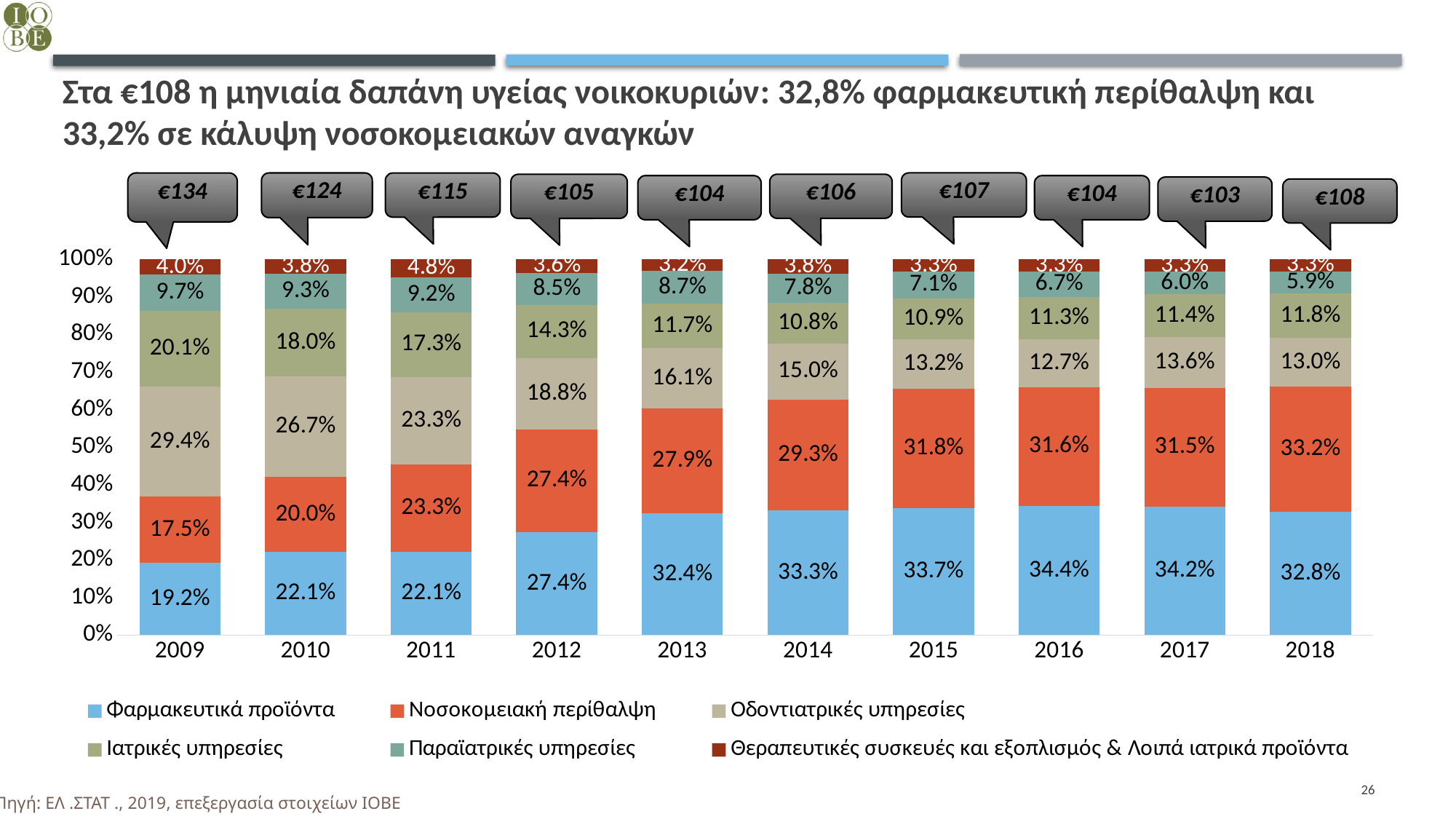
What share of household health spending went to Φαρμακευτικά προϊόντα in 2018? 32.8% What share did Οδοντιατρικές υπηρεσίες account for in 2009? 29.4% In 2018, which is larger: the share of Φαρμακευτικά προϊόντα or the share of Νοσοκομειακή περίθαλψη? Νοσοκομειακή περίθαλψη What monthly amount is shown in the callout above the 2012 bar? €105 Which year has the lowest monthly health expenditure shown in the callouts? 2017 How many years are shown on the x axis of the chart? 10 Does the share of Οδοντιατρικές υπηρεσίες rise or fall from 2009 to 2018? Fall By how many percentage points did the share of Νοσοκομειακή περίθαλψη change from 2009 to 2018? 15.7 percentage points Which year has the highest monthly health expenditure shown in the callouts? 2009 What type of chart is shown on the slide? Stacked bar chart How many series does the legend list? 6 Which series is shown in blue at the bottom of each bar? Φαρμακευτικά προϊόντα